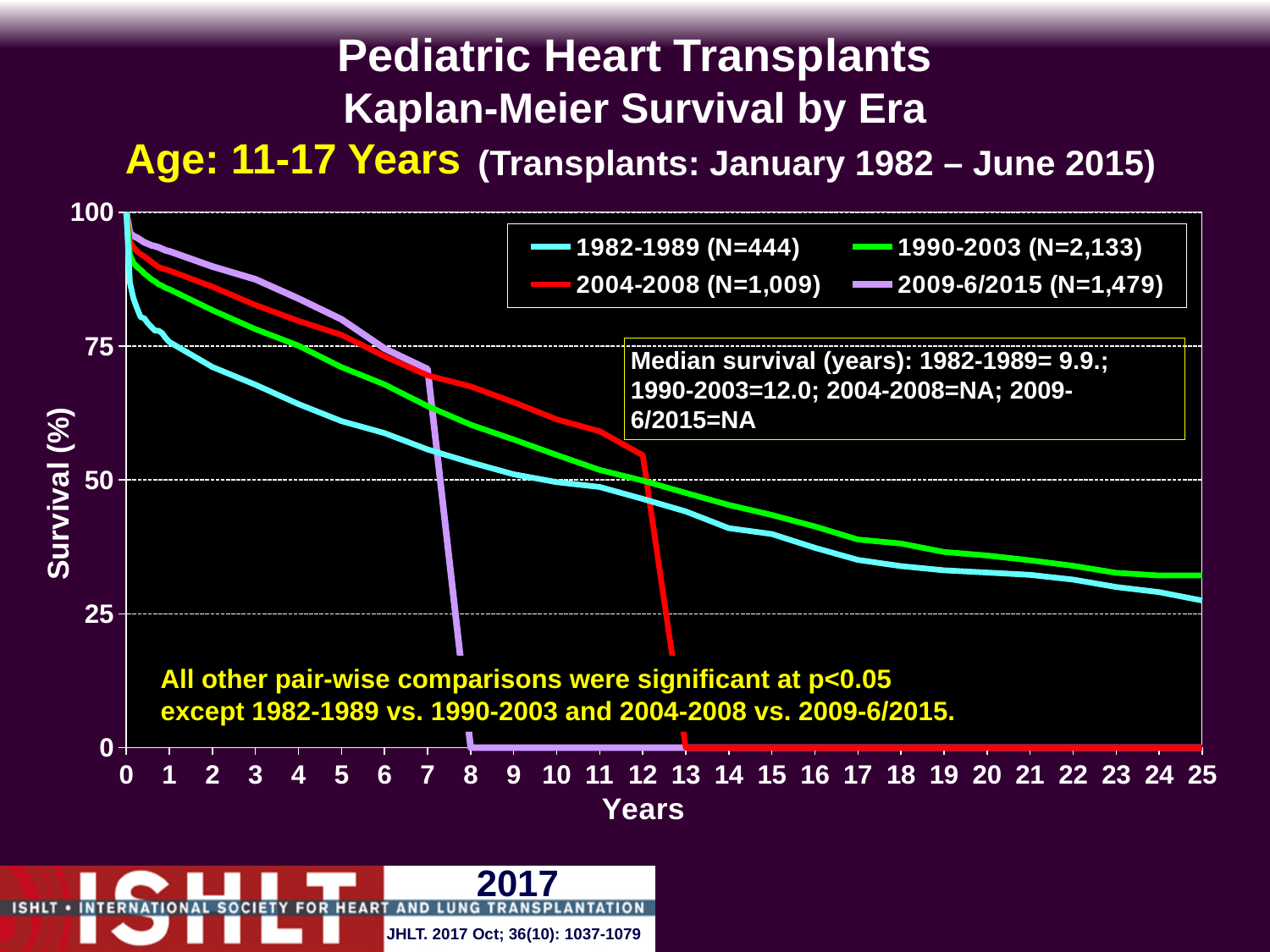
At 5 years, which era has higher survival, 1982-1989 or 2009-6/2015? 2009-6/2015 What is the median survival in years for the 1990-2003 era? 12.0 Which era has the largest N in the legend? 1990-2003 (N=2,133) Is the survival for the 1982-1989 era at 3 years greater or less than 75? less Is the survival for the 1982-1989 era at 25 years greater or less than 50? less Do the survival curves rise or fall as years increase along the x axis? fall Is the survival for the 1990-2003 era at 25 years greater or less than 25? greater Which eras are listed in the legend? 1982-1989, 1990-2003, 2004-2008, 2009-6/2015 What is the N for the 1982-1989 era shown in the legend? 444 What kind of chart is shown on the slide? line chart How many series does the legend list? 4 What is the median survival in years for the 1982-1989 era? 9.9